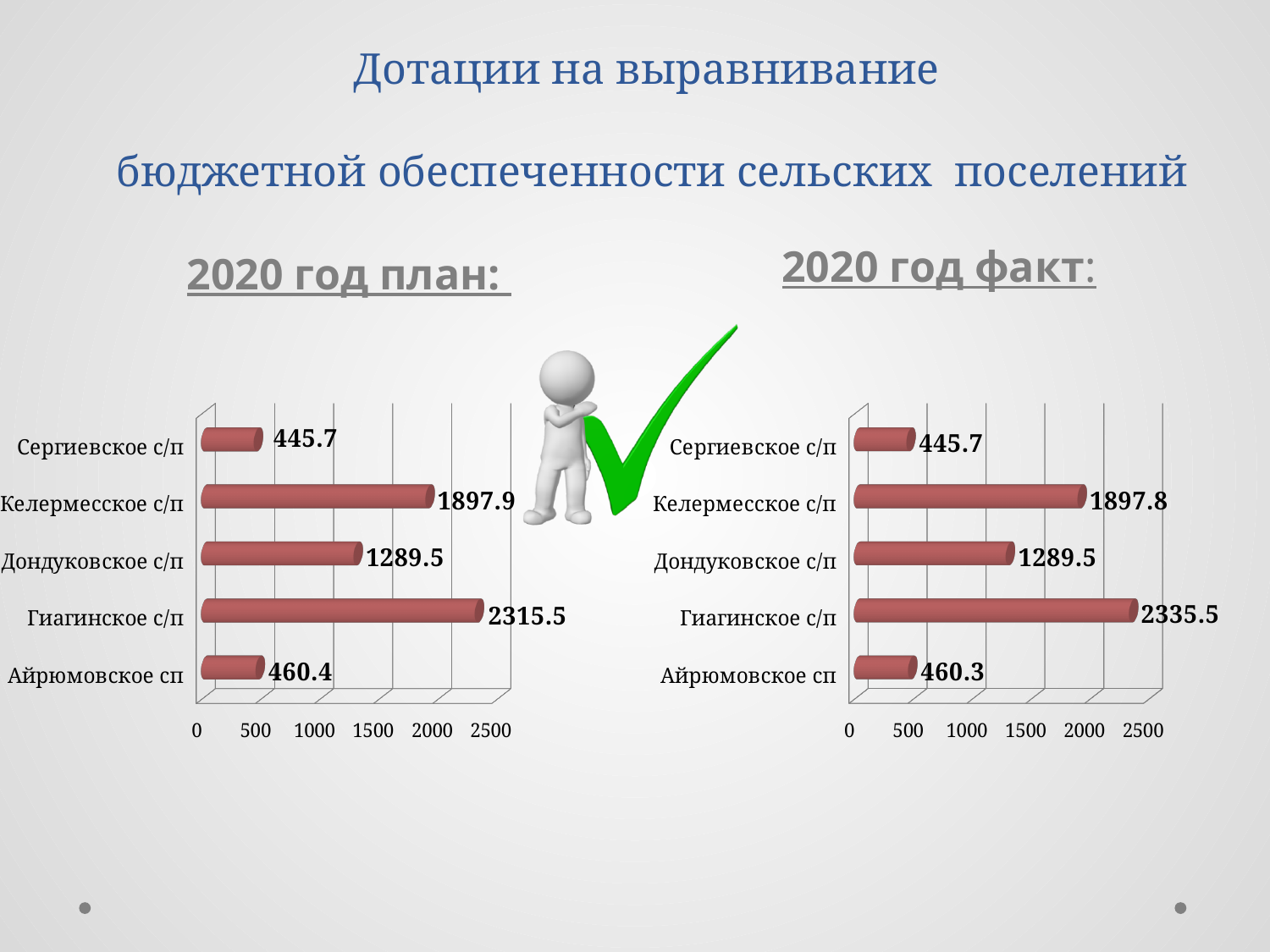
How many categories are shown in the "2020 год план" chart? 5 What is the difference between the Гиагинское с/п value in the "2020 год факт" chart and in the "2020 год план" chart? 20 What type of chart is the "2020 год факт" chart? bar chart In the "2020 год факт" chart, which category has the lowest value? Сергиевское с/п In the "2020 год факт" chart, what is the value for Гиагинское с/п? 2335.5 In the "2020 год план" chart, which category has the highest value? Гиагинское с/п In the "2020 год план" chart, what is the difference between the values for Гиагинское с/п and Дондуковское с/п? 1026 In the "2020 год план" chart, what is the value for Келермесское с/п? 1897.9 In the "2020 год план" chart, which is larger: the value for Айрюмовское сп or the value for Сергиевское с/п? Айрюмовское сп In the "2020 год факт" chart, what is the value for Айрюмовское сп? 460.3 In the "2020 год факт" chart, is the value for Дондуковское с/п greater or less than 1000? greater What is the highest tick value shown on the horizontal axis of the "2020 год план" chart? 2500